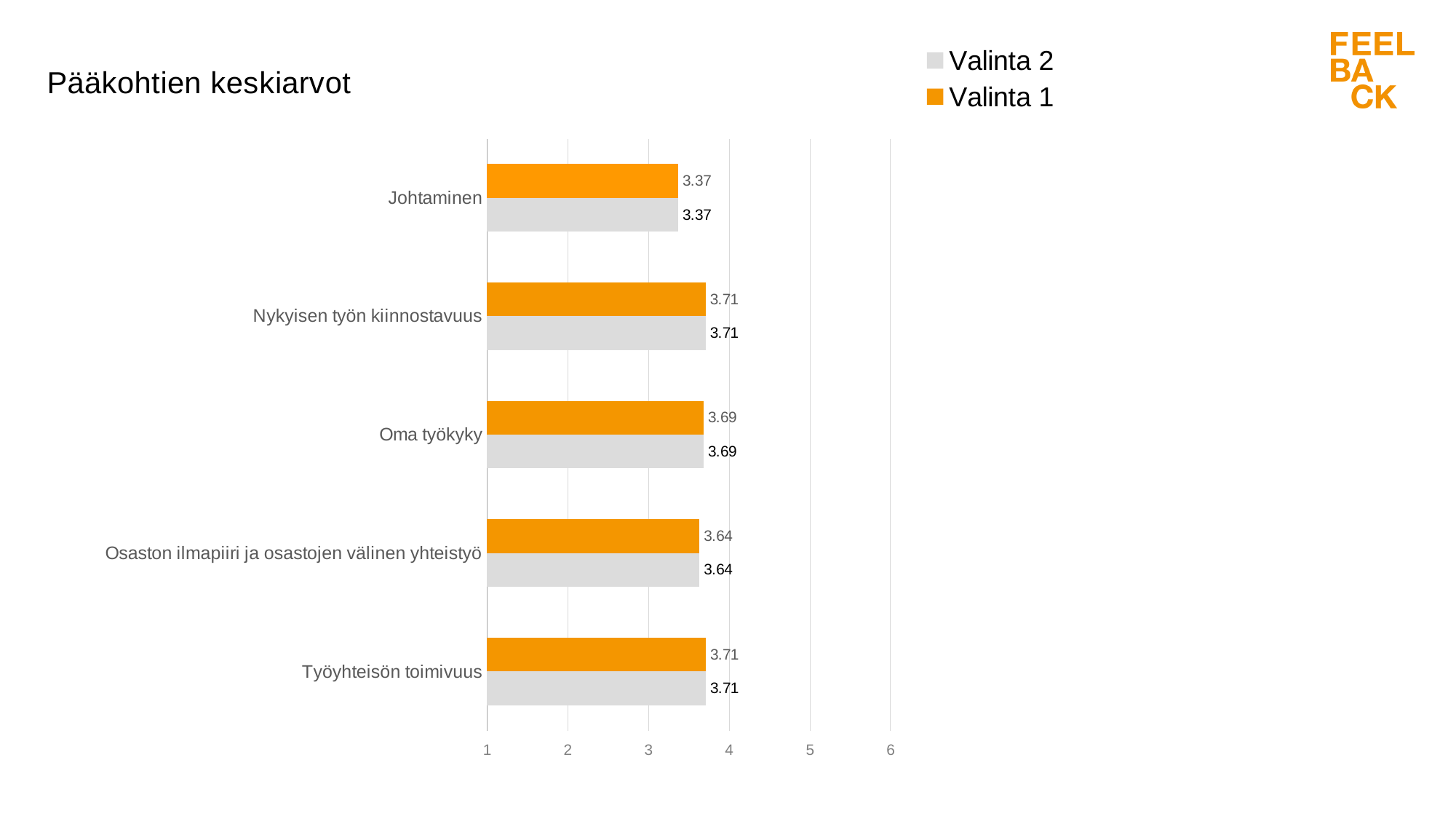
What is the title of the chart? Pääkohtien keskiarvot Which category has the lowest Valinta 1 value? Johtaminen Is the Valinta 2 value for Johtaminen greater or less than 4? less What is the difference between the Valinta 1 values for Nykyisen työn kiinnostavuus and Johtaminen? 0.34 How many series does the legend list? 2 What is the Valinta 2 value for Työyhteisön toimivuus? 3.71 What is the Valinta 2 value for Oma työkyky? 3.69 What is the Valinta 1 value for Johtaminen? 3.37 Which is larger, the Valinta 1 value for Oma työkyky or for Johtaminen? Oma työkyky What is the Valinta 1 value for Osaston ilmapiiri ja osastojen välinen yhteistyö? 3.64 How many categories are shown on the chart? 5 What kind of chart is shown on the slide? Bar chart